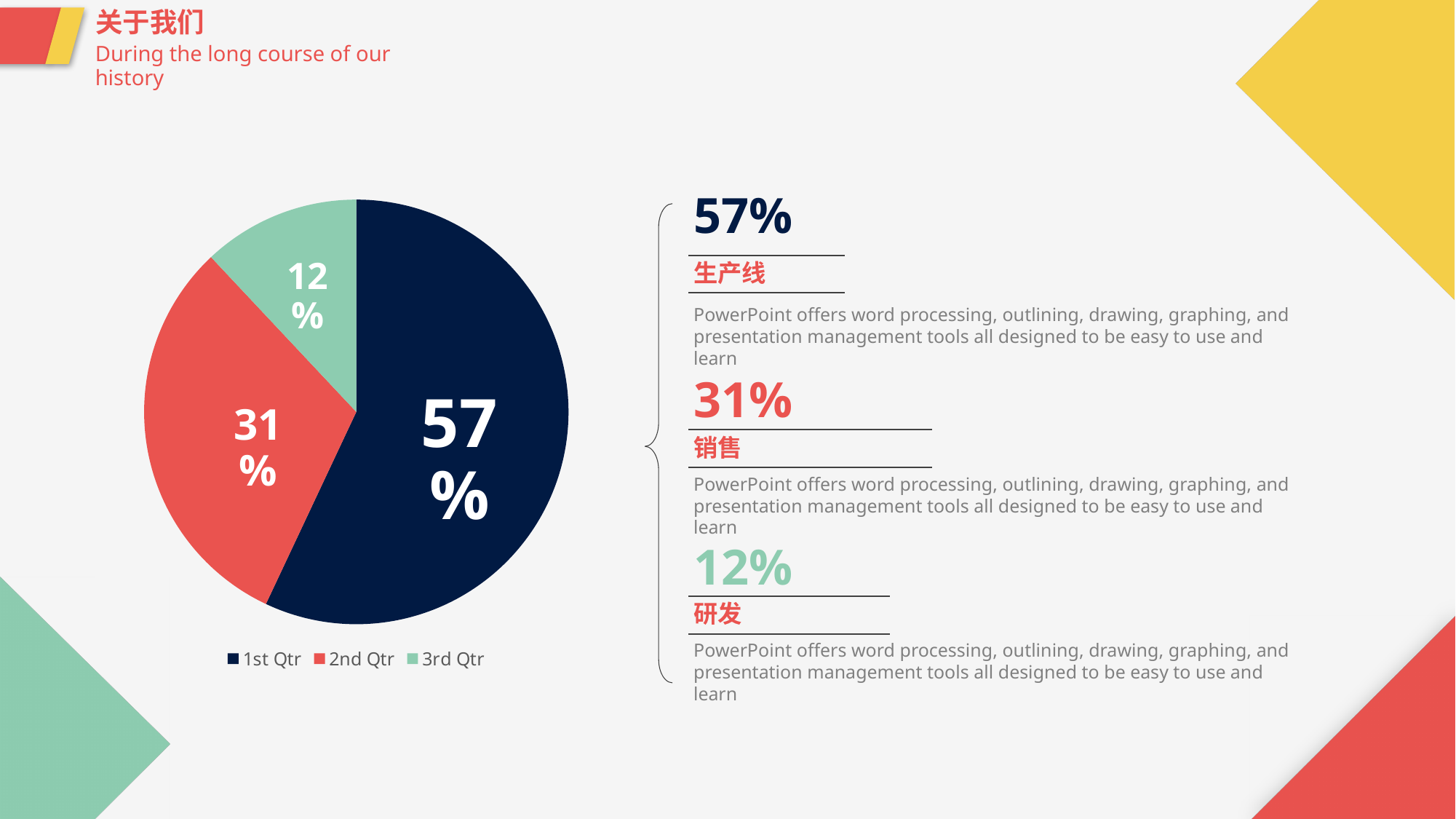
What is the value for 2nd Qtr in the pie chart? 31% Which category has the smallest slice in the pie chart? 3rd Qtr What kind of chart is shown on the slide? pie chart What is the value for 3rd Qtr in the pie chart? 12% What colour is the 2nd Qtr slice in the pie chart? red What is the difference between the 2nd Qtr and 3rd Qtr values? 19% Which category has the largest slice in the pie chart? 1st Qtr What is the difference between the 1st Qtr and 2nd Qtr values? 26% What is the value for 1st Qtr in the pie chart? 57% How many entries does the legend list? 3 Which is larger, the 2nd Qtr slice or the 3rd Qtr slice? 2nd Qtr How many slices does the pie chart have? 3